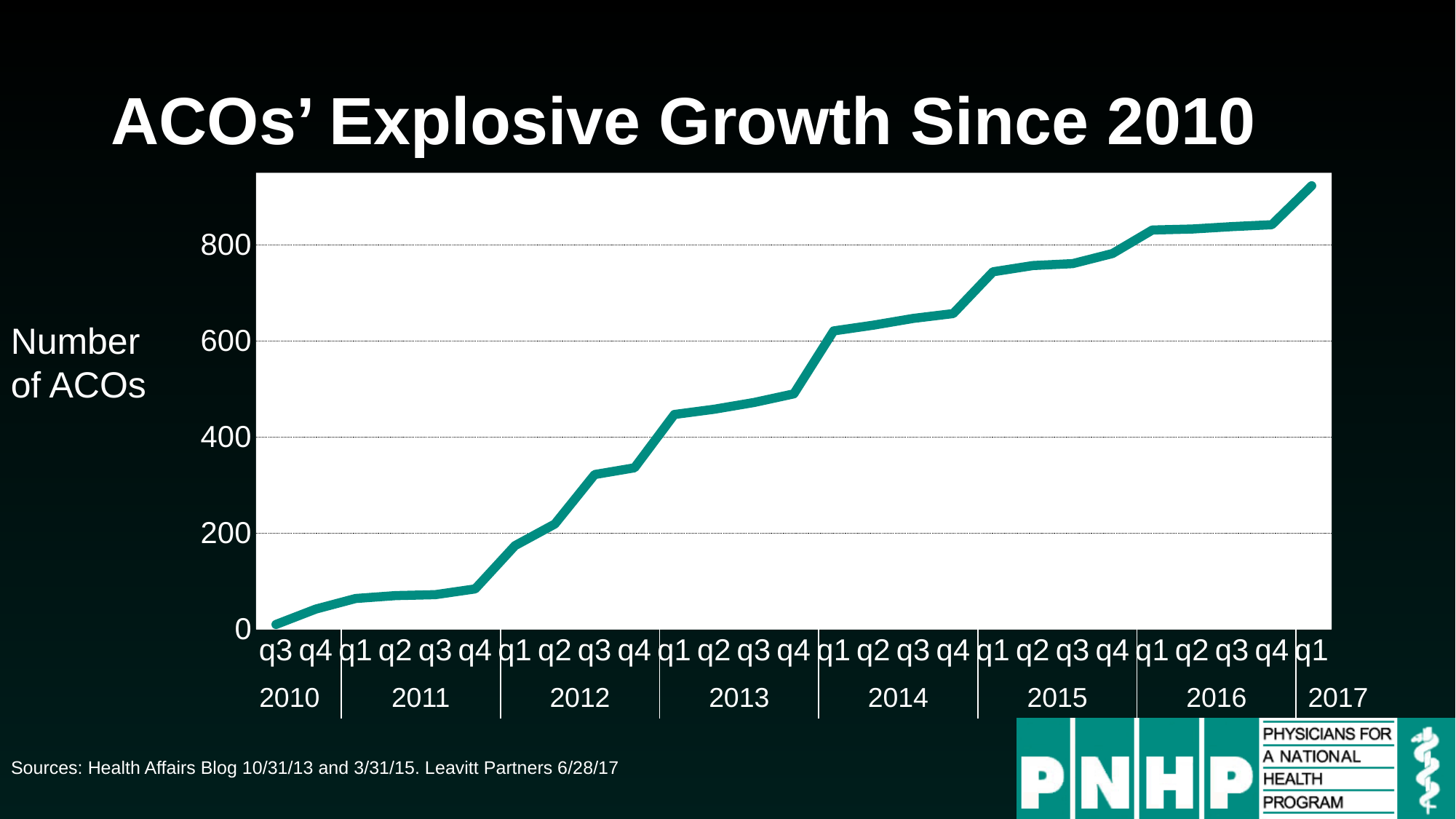
Which quarter has the lowest number of ACOs? q3 2010 Is the value for q4 2011 greater or less than 200? less What does the vertical axis of the chart measure? Number of ACOs How many quarterly data points are plotted on the chart? 27 Which quarter has the highest number of ACOs? q1 2017 Do the values rise or fall from q3 2010 to q1 2017? rise Is the value for q1 2015 greater or less than 800? less Is the value for q1 2017 greater or less than 800? greater Which is larger, the value for q1 2013 or the value for q4 2011? q1 2013 What kind of chart is shown on the slide? line chart What is the title of the chart? ACOs' Explosive Growth Since 2010